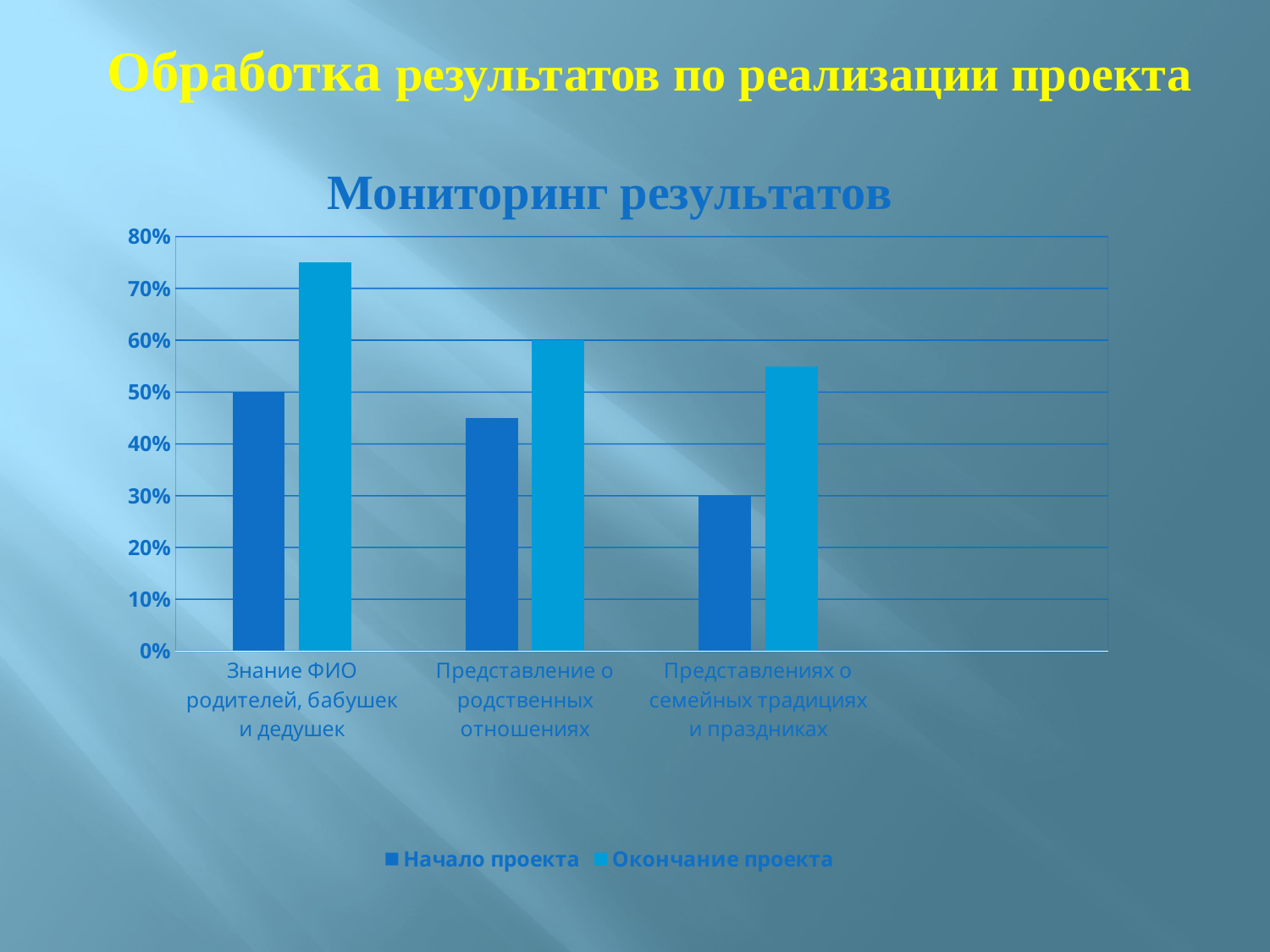
What is the value for 'Окончание проекта' in the category 'Представление о родственных отношениях'? 60% What kind of chart is shown on the slide? bar chart Is the value for 'Окончание проекта' in the category 'Знание ФИО родителей, бабушек и дедушек' greater or less than 70%? greater Which category has the highest value for 'Окончание проекта'? Знание ФИО родителей, бабушек и дедушек Is the value for 'Начало проекта' in the category 'Представление о родственных отношениях' greater or less than 50%? less Is the value for 'Окончание проекта' in the category 'Представлениях о семейных традициях и праздниках' greater or less than 50%? greater How many categories are shown on the x axis? 3 What is the title of the chart? Мониторинг результатов Which category has the lowest value for 'Начало проекта'? Представлениях о семейных традициях и праздниках What is the value for 'Начало проекта' in the category 'Представлениях о семейных традициях и праздниках'? 30% How many series does the legend list? 2 What is the value for 'Начало проекта' in the category 'Знание ФИО родителей, бабушек и дедушек'? 50%